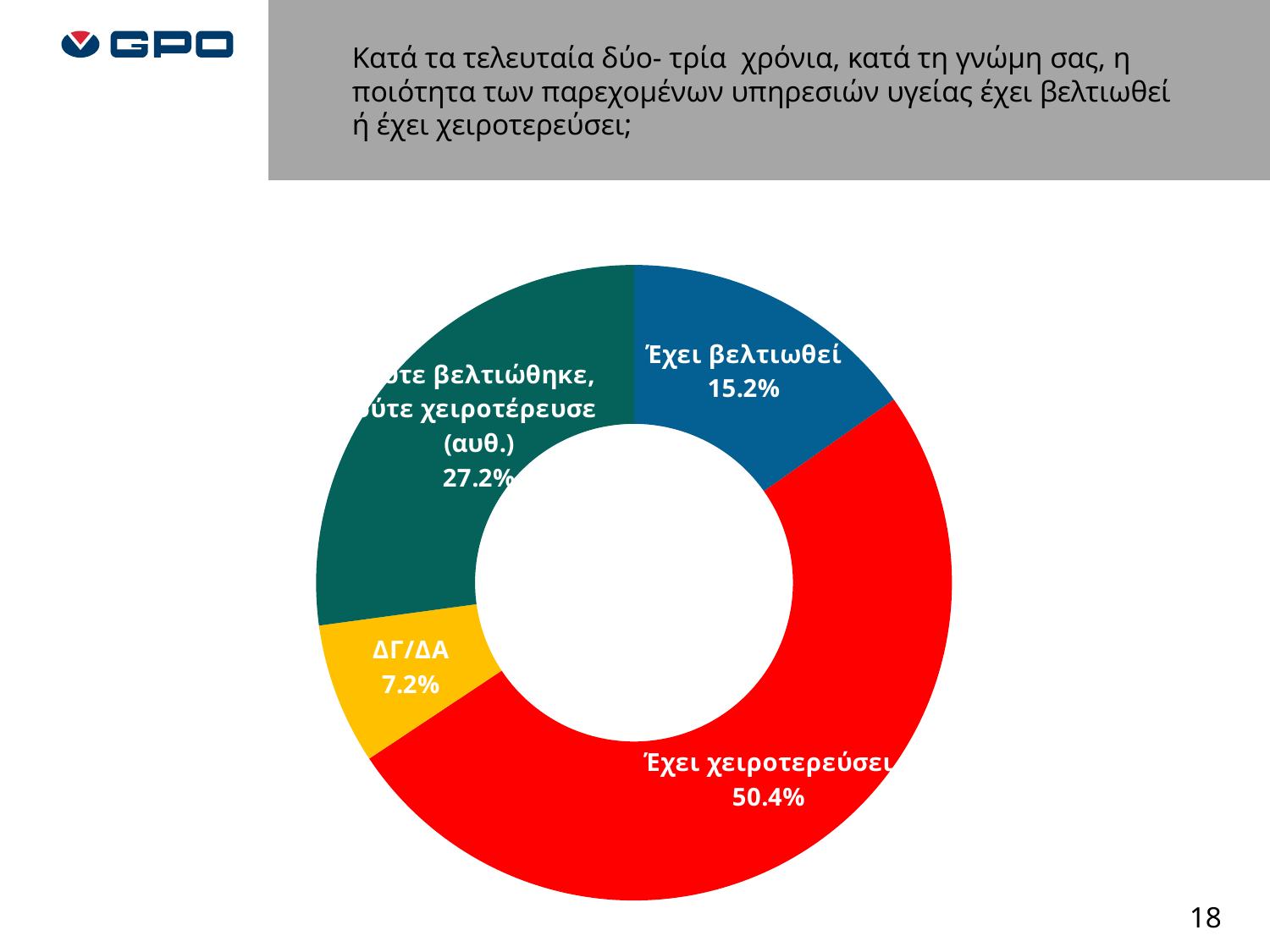
What percentage is shown for "Ούτε βελτιώθηκε, ούτε χειροτέρευσε (αυθ.)"? 27.2% What is the difference in percentage points between "Έχει χειροτερεύσει" and "Έχει βελτιωθεί"? 35.2 What is the value of the "ΔΓ/ΔΑ" slice? 7.2% How many slices does the chart have? 4 What share of respondents answered "Έχει χειροτερεύσει"? 50.4% Which response has the largest share of the chart? Έχει χειροτερεύσει What is the difference in percentage points between "Ούτε βελτιώθηκε, ούτε χειροτέρευσε (αυθ.)" and "ΔΓ/ΔΑ"? 20.0 What kind of chart is shown on the slide? Doughnut (pie) chart Which response has the smallest share of the chart? ΔΓ/ΔΑ Which is larger: the share for "Έχει βελτιωθεί" or the share for "Ούτε βελτιώθηκε, ούτε χειροτέρευσε (αυθ.)"? Ούτε βελτιώθηκε, ούτε χειροτέρευσε (αυθ.) What colour is the "Έχει χειροτερεύσει" slice? Red What percentage is shown for "Έχει βελτιωθεί"? 15.2%